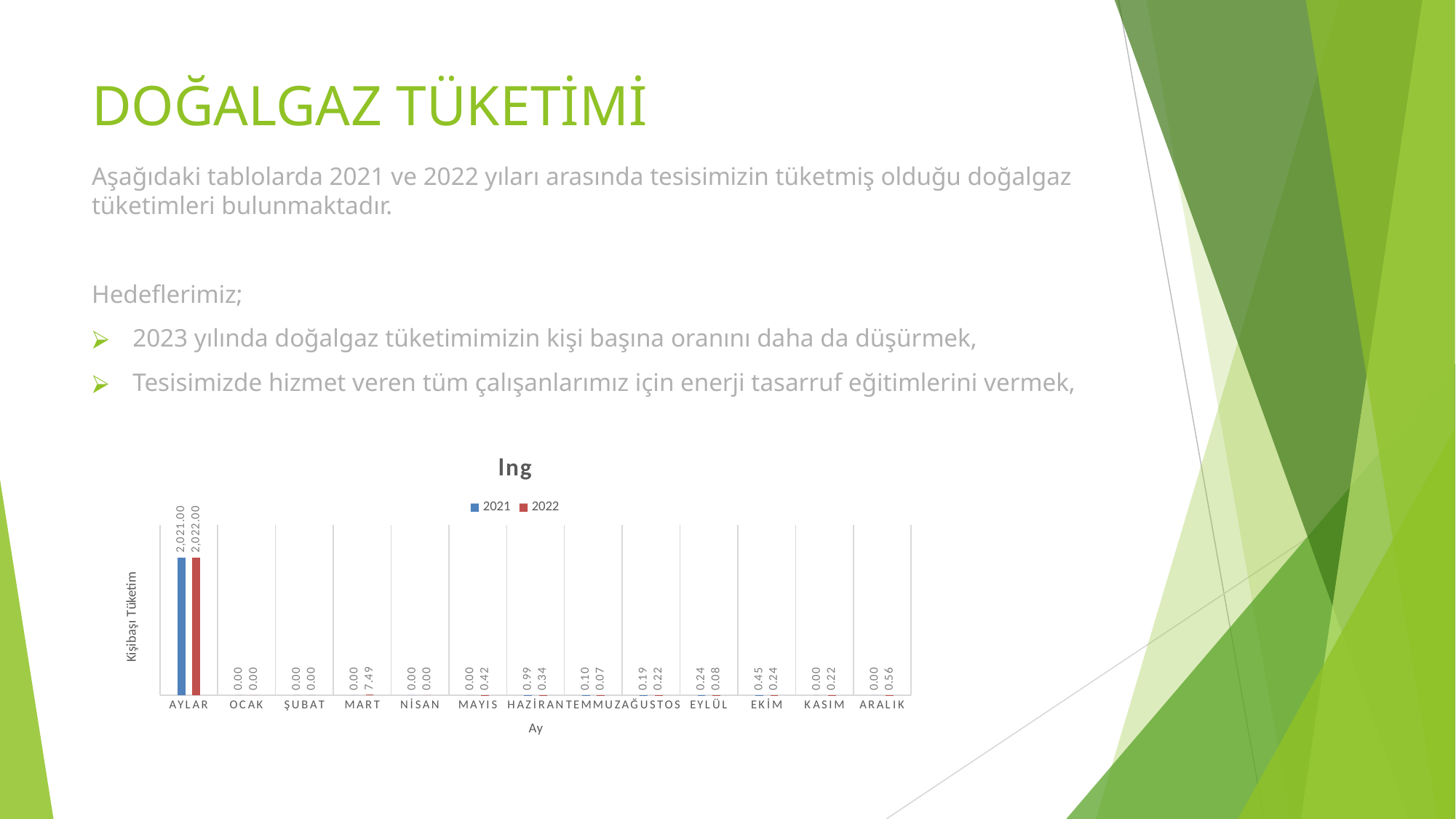
What is the 2021 value for HAZİRAN? 0.99 What is the label of the vertical axis? Kişibaşı Tüketim What is the 2022 value for MART? 7.49 Excluding the AYLAR category, which month has the highest 2021 value? HAZİRAN Which is larger for EYLÜL, the 2021 value or the 2022 value? 2021 What is the title of the chart? lng How many series does the chart legend list? 2 What is the 2021 value for EKİM? 0.45 What type of chart is shown on the slide? bar chart What is the 2022 value for ARALIK? 0.56 What is the difference between the 2021 and 2022 values for HAZİRAN? 0.65 Excluding the AYLAR category, which month has the highest 2022 value? MART